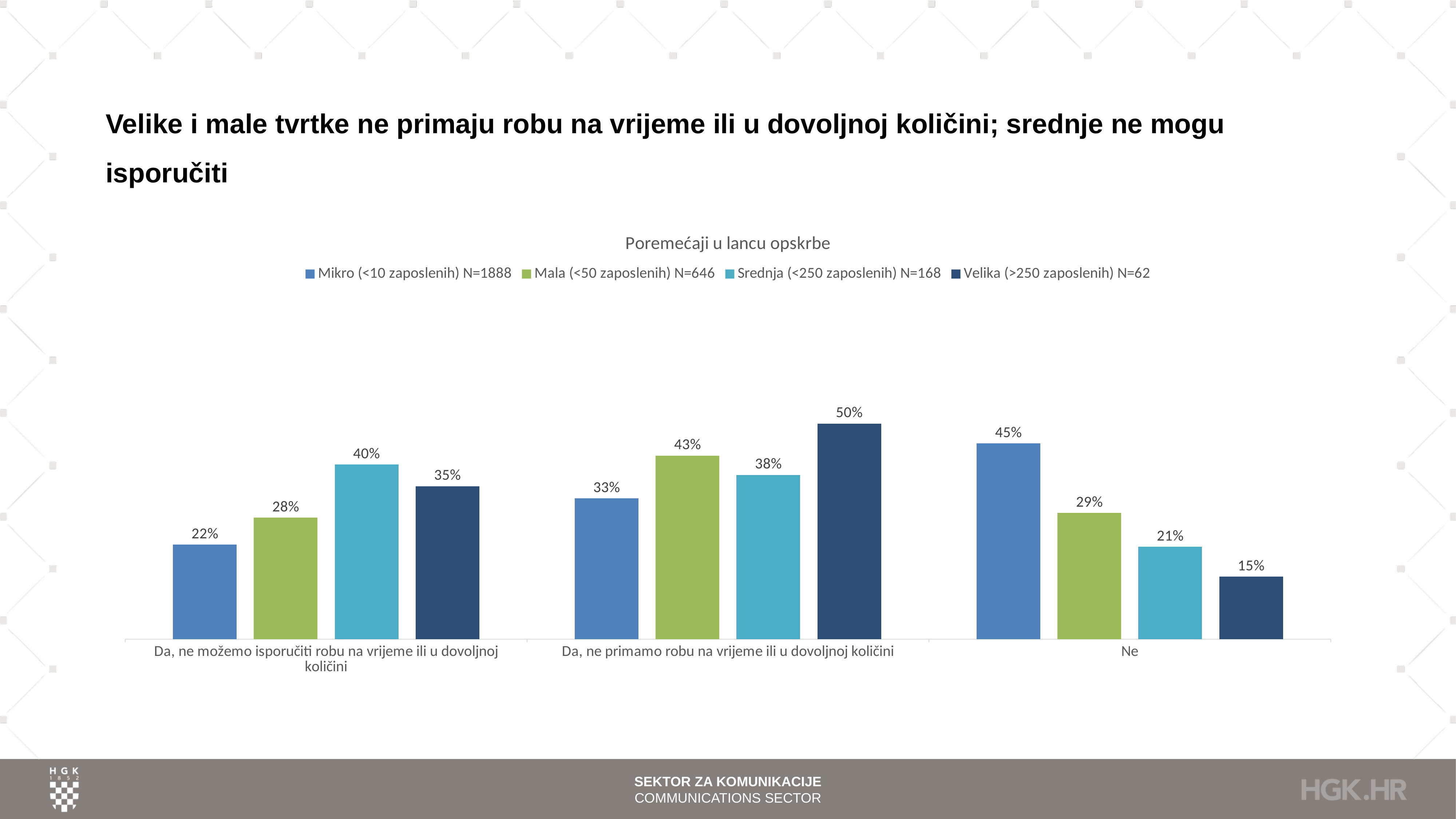
What is the value for Mikro (<10 zaposlenih) in the 'Ne' category? 45% What is the value for Velika (>250 zaposlenih) in the 'Da, ne primamo robu na vrijeme ili u dovoljnoj količini' category? 50% Which series has the lowest value in the 'Ne' category? Velika (>250 zaposlenih) N=62 What is the difference between the Mala and Mikro values in the 'Da, ne možemo isporučiti robu na vrijeme ili u dovoljnoj količini' category? 6% What is the value for Srednja (<250 zaposlenih) in the 'Da, ne možemo isporučiti robu na vrijeme ili u dovoljnoj količini' category? 40% How many categories are shown on the x axis? 3 What is the title of the chart? Poremećaji u lancu opskrbe What kind of chart is shown on the slide? Bar chart Which is larger in the 'Ne' category: the Mala value or the Srednja value? Mala (<50 zaposlenih) N=646 How many series does the legend list? 4 Which series has the highest value in the 'Da, ne primamo robu na vrijeme ili u dovoljnoj količini' category? Velika (>250 zaposlenih) N=62 What is the difference between the Velika values in the 'Da, ne primamo robu na vrijeme ili u dovoljnoj količini' and 'Ne' categories? 35%